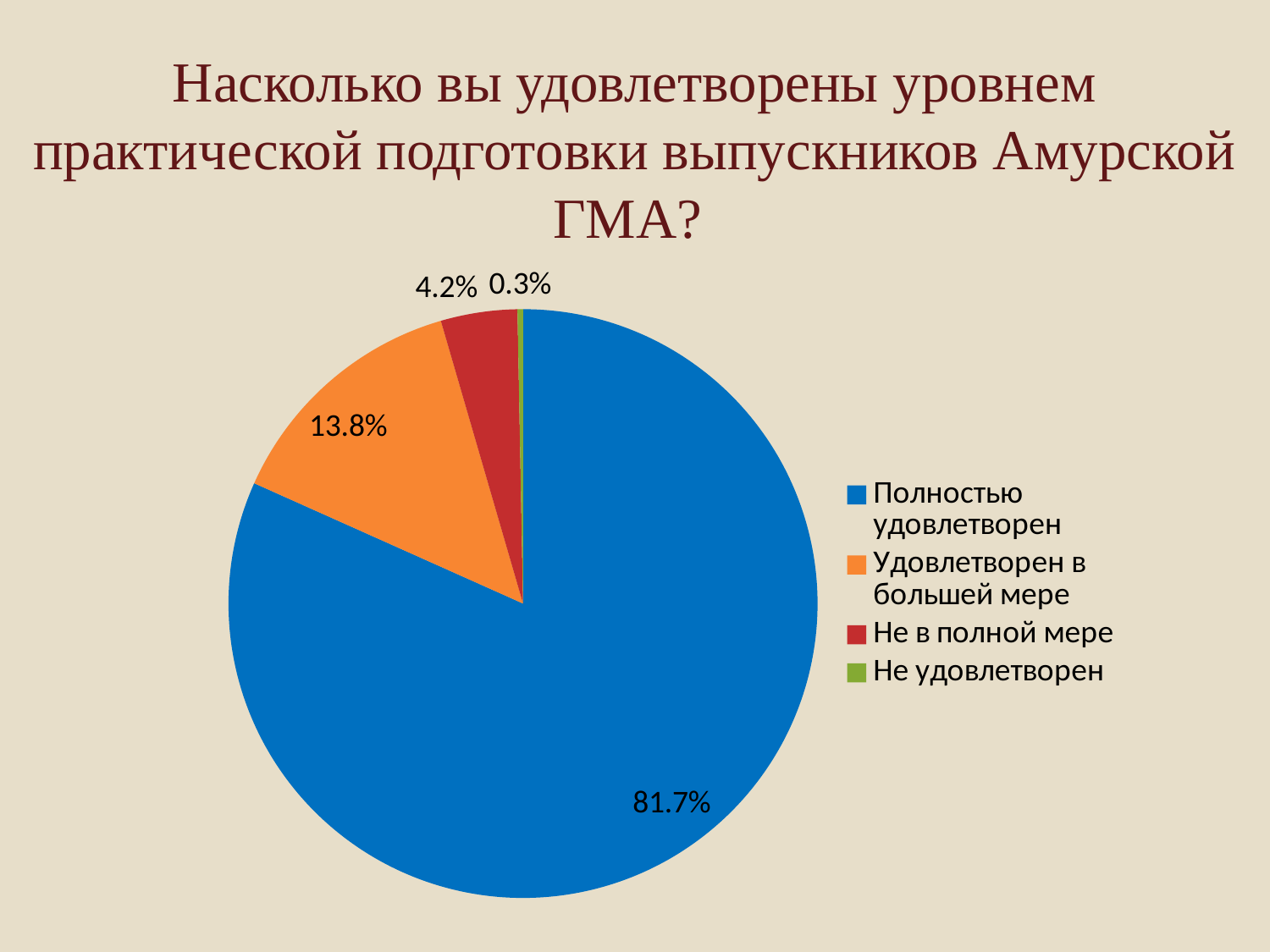
What share of respondents answered "Полностью удовлетворен"? 81.7% What share of respondents answered "Не удовлетворен"? 0.3% What colour is the slice for "Удовлетворен в большей мере"? orange What share of respondents answered "Удовлетворен в большей мере"? 13.8% What is the difference between the shares for "Удовлетворен в большей мере" and "Не в полной мере"? 9.6% Which category has the smallest slice of the pie? Не удовлетворен What is the difference between the shares for "Полностью удовлетворен" and "Удовлетворен в большей мере"? 67.9% Which category has the largest slice of the pie? Полностью удовлетворен What share of respondents answered "Не в полной мере"? 4.2% Which is larger: the share for "Не в полной мере" or the share for "Не удовлетворен"? Не в полной мере What kind of chart is shown on the slide? pie chart How many categories does the legend list? 4